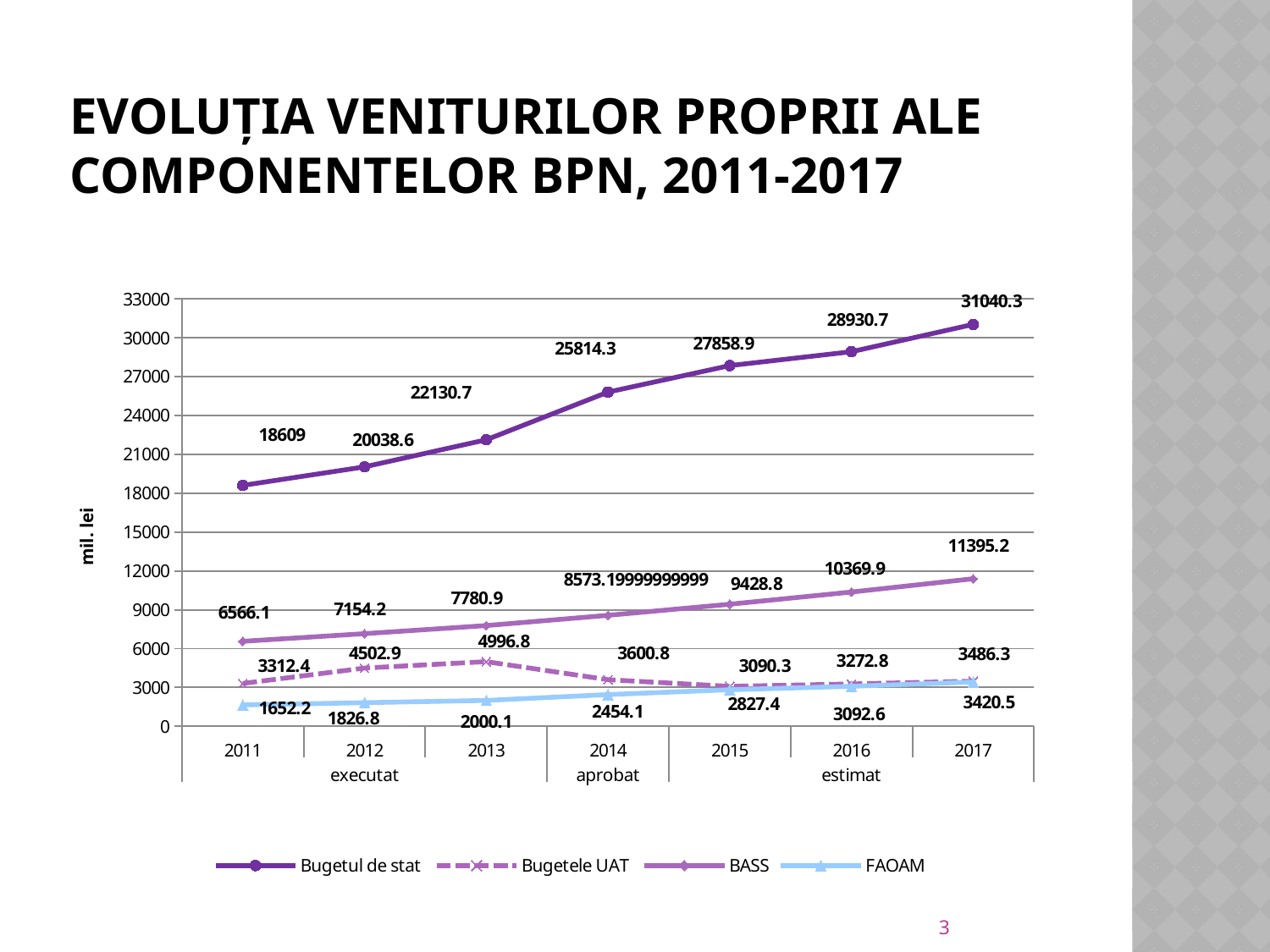
What is the value for Bugetele UAT in 2013? 4996.8 What is the value for Bugetul de stat in 2017? 31040.3 What kind of chart is shown on the slide? Line chart Is the value for Bugetul de stat in 2014 greater or less than 24000? greater In which year is the Bugetul de stat value lowest? 2011 How many series does the legend list? 4 What is the value for BASS in 2016? 10369.9 What is the difference between the Bugetul de stat values in 2017 and 2011? 12431.3 In which year is the Bugetele UAT value highest? 2013 Does the FAOAM series rise or fall from 2011 to 2017? Rise Which is larger in 2014: the BASS value or the Bugetele UAT value? BASS What is the value for FAOAM in 2011? 1652.2